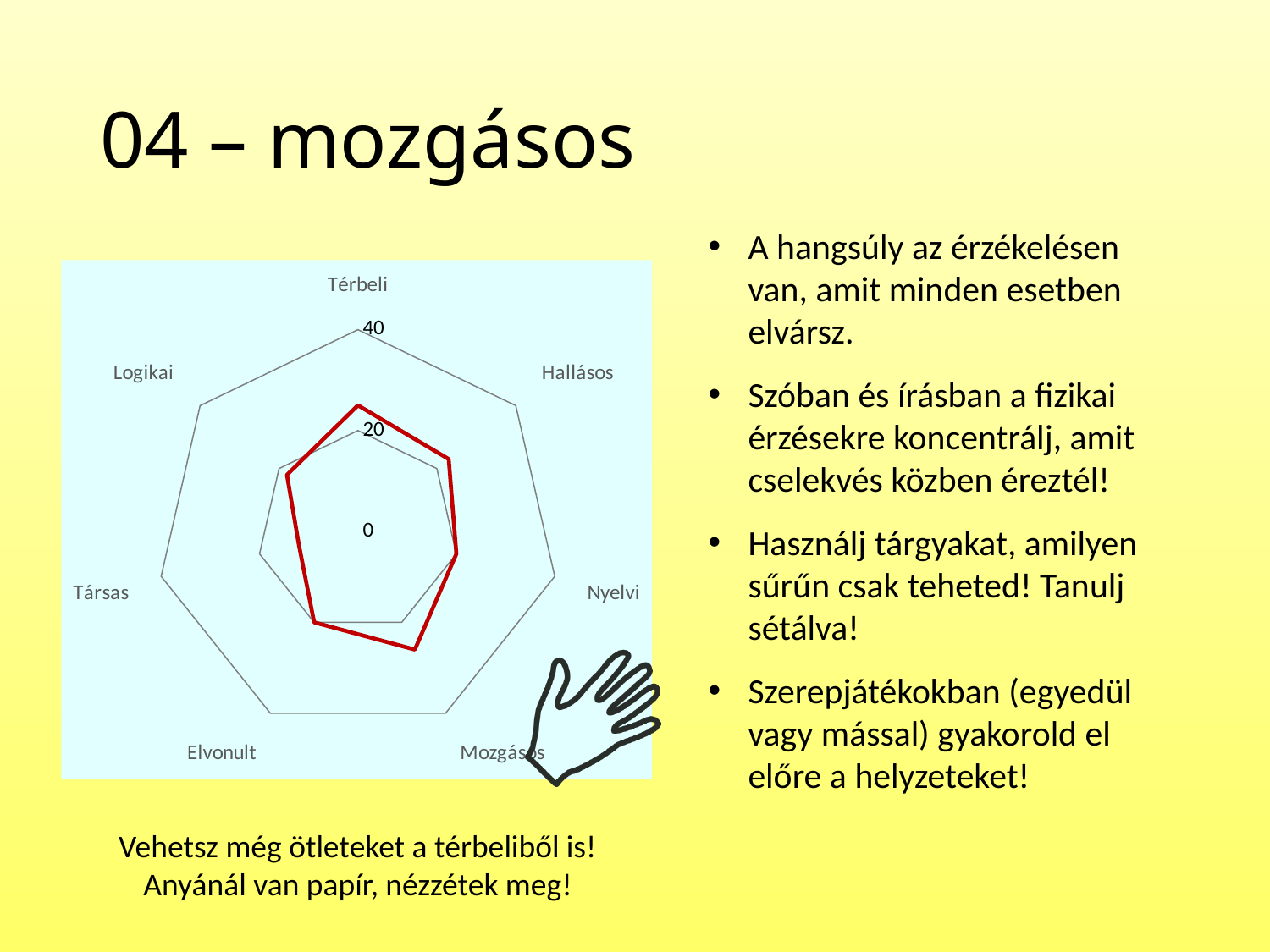
Which category has the lowest value on the radar chart? Társas Which is larger, the value for Hallásos or the value for Társas? Hallásos What kind of chart is shown on the slide? radar chart Which is larger, the value for Térbeli or the value for Nyelvi? Térbeli Is the value for Térbeli greater or less than 20? greater What is the highest tick value shown on the radar chart's axis? 40 How many categories (axes) does the radar chart have? 7 Is the value for Társas greater or less than 20? less Is the value for Térbeli greater or less than 40? less